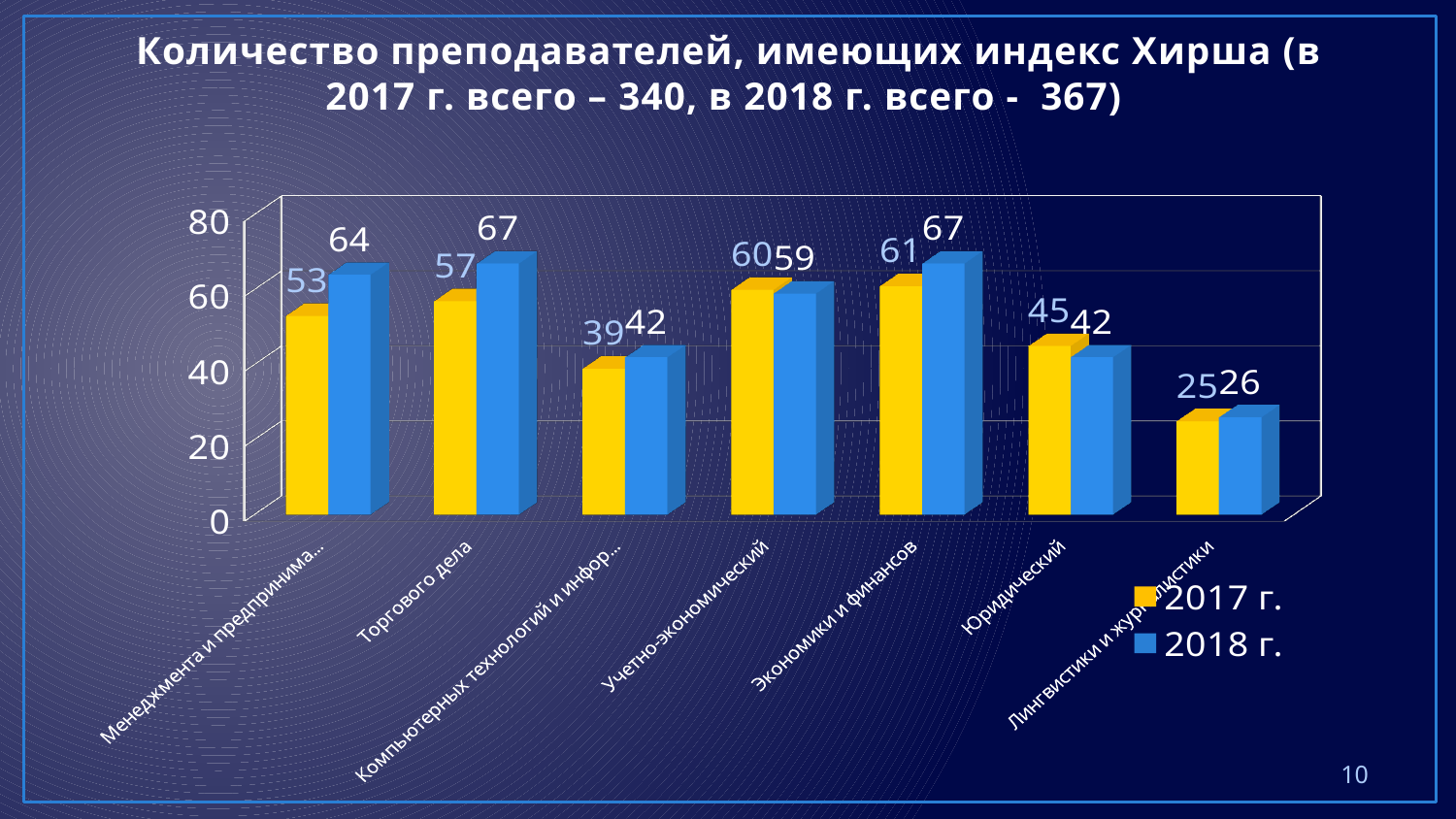
Which colour represents the 2018 г. series? Blue Which category has the highest value in the 2017 г. series? Экономики и финансов How many categories are shown on the x axis? 7 Which is larger for Учетно-экономический: the 2017 г. value or the 2018 г. value? 2017 г. What is the value for Торгового дела in the 2018 г. series? 67 Which category has the lowest value in the 2017 г. series? Лингвистики и журналистики What is the value for Учетно-экономический in the 2018 г. series? 59 What is the difference between the 2018 г. and 2017 г. values for Торгового дела? 10 What is the value for Юридический in the 2017 г. series? 45 Which is larger for Экономики и финансов: the 2017 г. value or the 2018 г. value? 2018 г. How many series does the legend list? 2 What kind of chart is shown on the slide? Bar chart